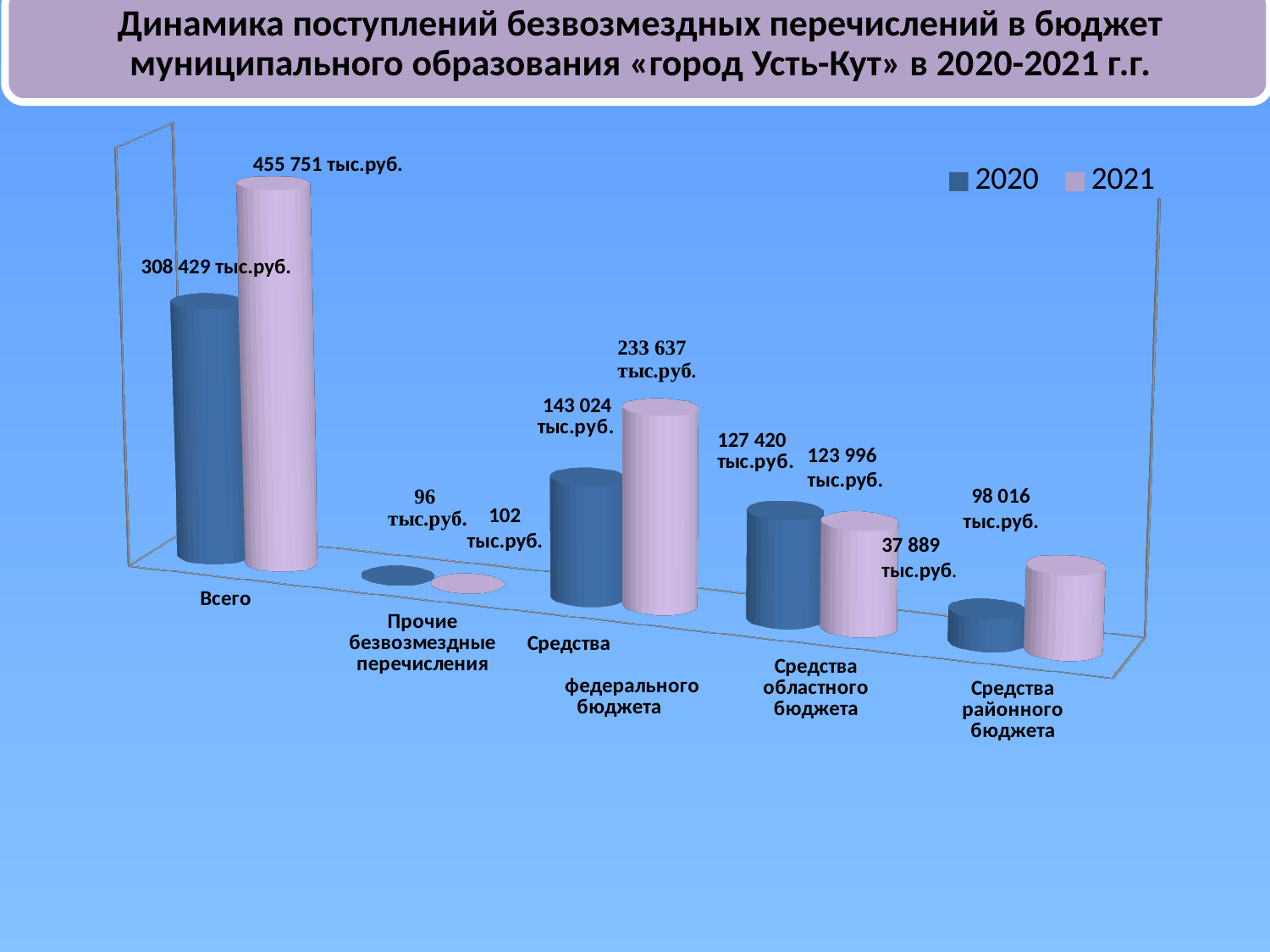
What is the 2021 value for «Средства федерального бюджета»? 233 637 тыс.руб. How many categories are shown on the x axis? 5 What is the value for «Всего» in 2020? 308 429 тыс.руб. What is the value for «Всего» in 2021? 455 751 тыс.руб. What is the 2020 value for «Средства районного бюджета»? 37 889 тыс.руб. Which is larger for «Средства областного бюджета»: the 2020 value or the 2021 value? 2020 What kind of chart is shown on the slide? Bar chart Excluding «Всего», which category has the highest value in the 2021 series? Средства федерального бюджета Which series is shown in the light pink colour in the legend? 2021 Which category has the lowest value in the 2020 series? Прочие безвозмездные перечисления What is the difference between the 2021 and 2020 values for «Всего»? 147 322 тыс.руб. How many series does the legend list? 2